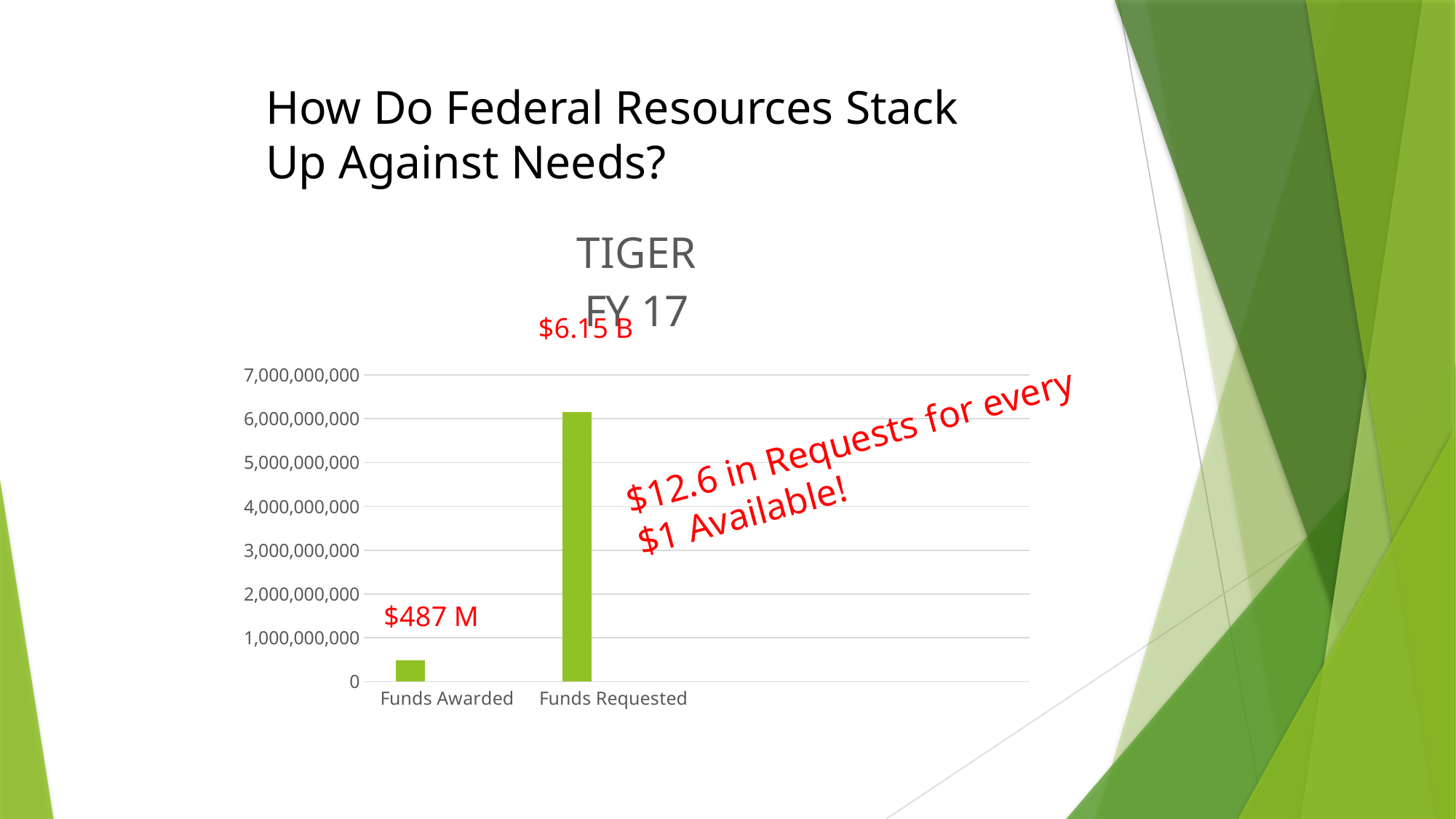
What value is labelled for Funds Awarded in the TIGER FY 17 chart? $487 M How many categories are shown on the x axis of the TIGER FY 17 chart? 2 According to the red annotation on the chart, how many dollars in requests are there for every $1 available? $12.6 Is the value for Funds Requested greater or less than 6,000,000,000? greater Which category has the highest bar in the TIGER FY 17 chart? Funds Requested Which category has the lowest bar in the TIGER FY 17 chart? Funds Awarded What is the highest value shown on the y axis of the TIGER FY 17 chart? 7,000,000,000 Is the value for Funds Awarded greater or less than 1,000,000,000? less What kind of chart is shown on the slide? Bar chart What is the title of the chart on the slide? TIGER FY 17 Which is larger in the TIGER FY 17 chart, Funds Awarded or Funds Requested? Funds Requested What value is labelled for Funds Requested in the TIGER FY 17 chart? $6.15 B